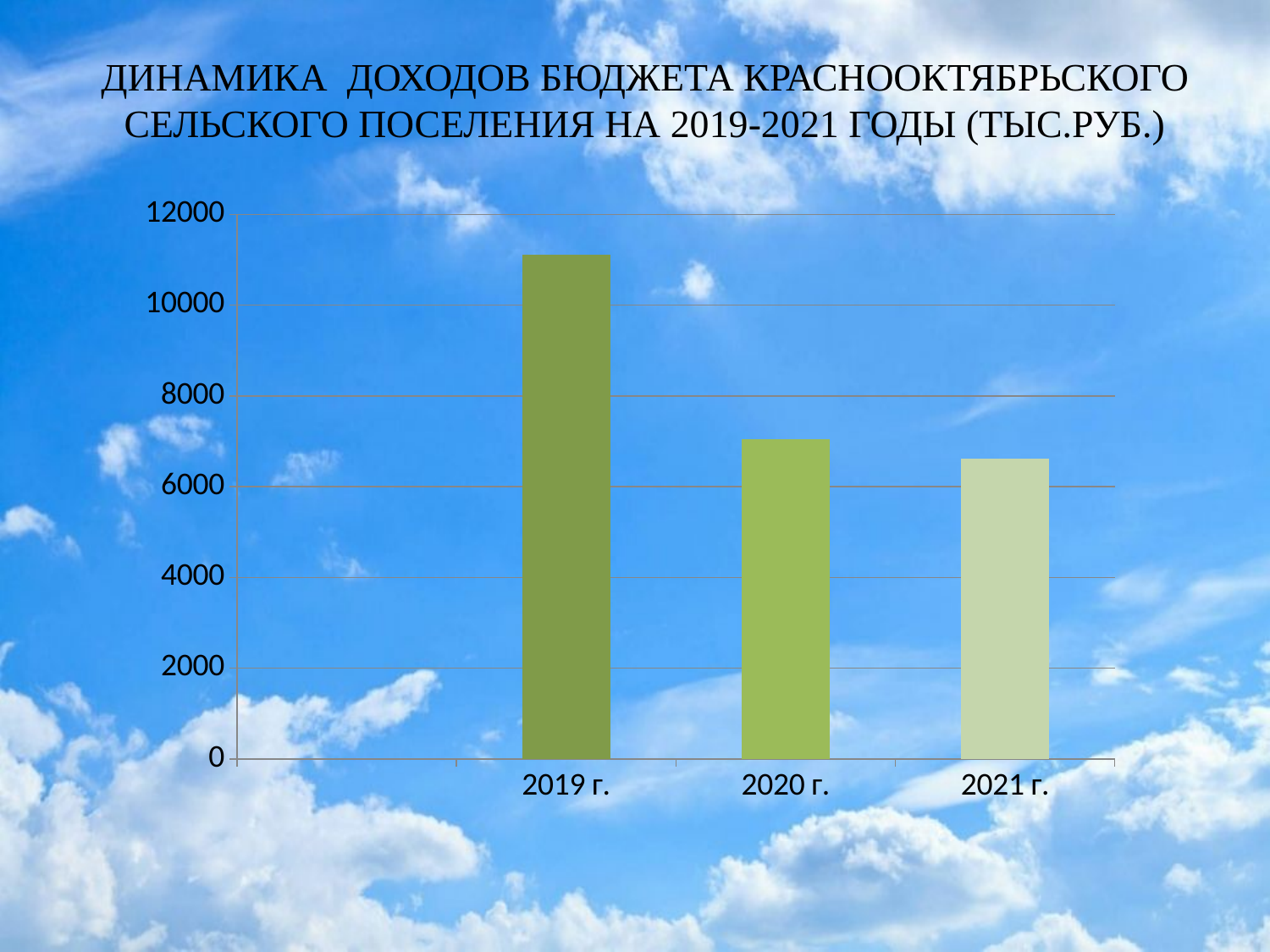
Is the value for 2021 г. greater or less than 6000? greater How many years (categories) are plotted on the chart? 3 What kind of chart is shown on the slide? bar chart Is the value for 2020 г. greater or less than 8000? less Is the value for 2019 г. greater or less than 10000? greater Which year has the lowest budget income on the chart? 2021 г. In what units are the budget incomes given according to the slide title? тыс.руб. Which is larger, the value for 2020 г. or the value for 2021 г.? 2020 г. Which year has the highest budget income on the chart? 2019 г. Do the values rise or fall from 2019 г. to 2021 г.? fall Which is larger, the value for 2019 г. or the value for 2020 г.? 2019 г.